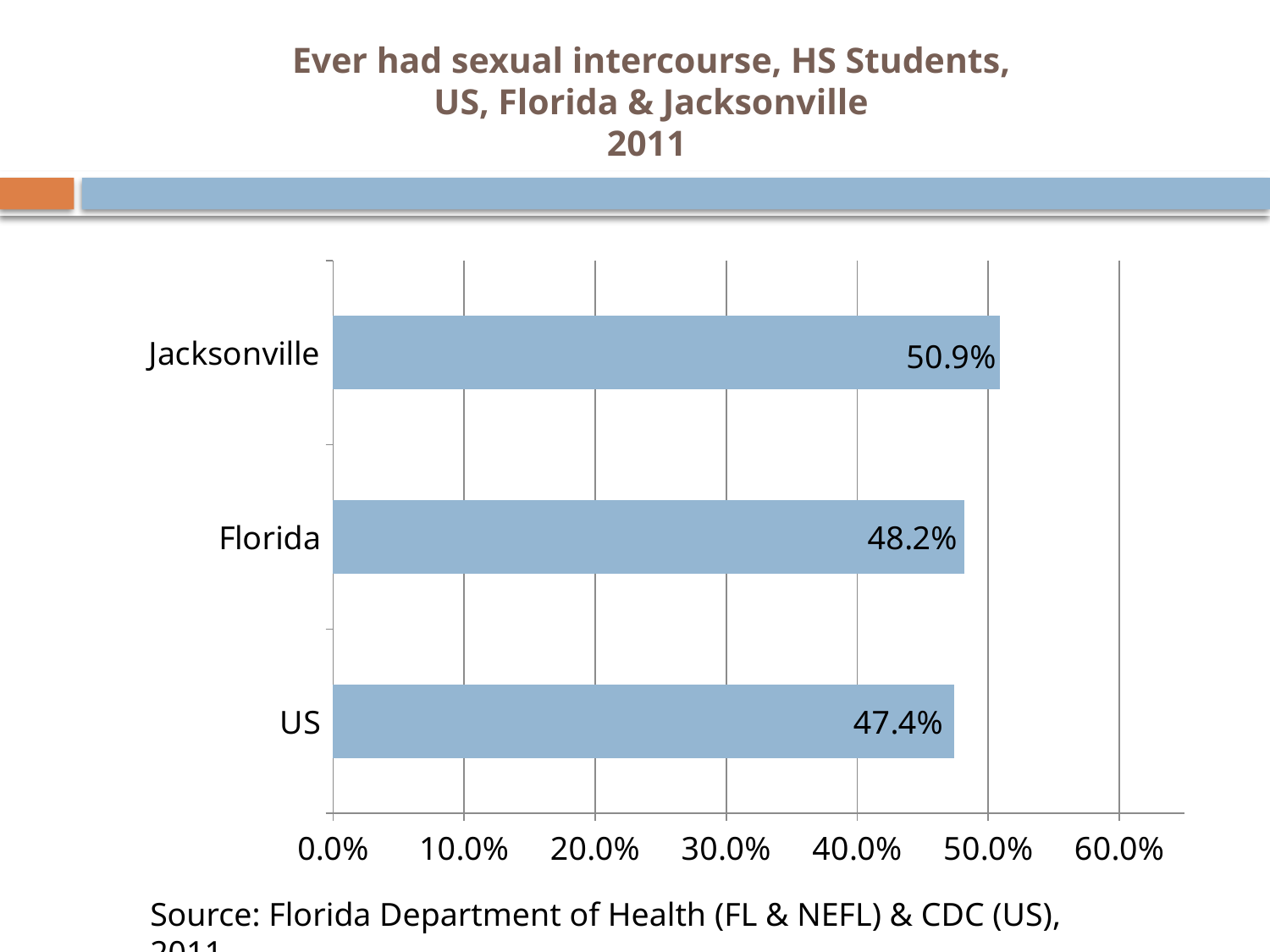
Is the value for Jacksonville greater or less than 50.0%? greater Which category has the lowest value? US What is the value for Florida? 48.2% Which category has the highest value? Jacksonville How many categories are shown in the chart? 3 What is the difference between the Jacksonville and US values? 3.5% What is the value for Jacksonville? 50.9% Which is larger, the value for Jacksonville or the value for Florida? Jacksonville What year does the chart title refer to? 2011 What is the difference between the Florida and US values? 0.8% What is the value for US? 47.4% What kind of chart is shown on the slide? bar chart